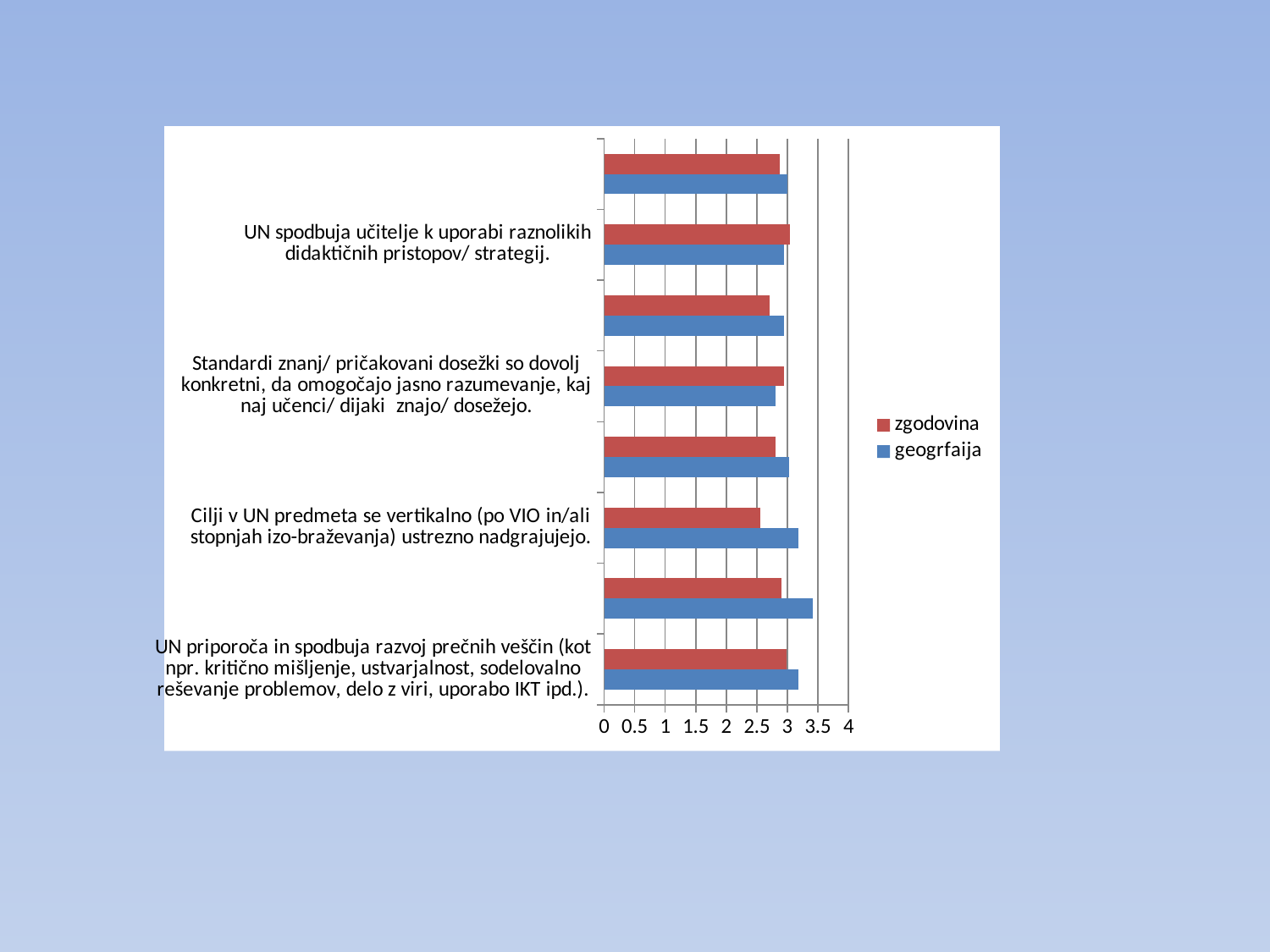
What kind of chart is shown on the slide? bar chart Is the zgodovina value for 'UN spodbuja učitelje k uporabi raznolikih didaktičnih pristopov/ strategij.' greater or less than 3.5? less Which colour represents the series zgodovina? red What are the two series named in the legend? zgodovina and geogrfaija How many series does the legend list? 2 Is the zgodovina value for 'UN priporoča in spodbuja razvoj prečnih veščin (kot npr. kritično mišljenje, ustvarjalnost, sodelovalno reševanje problemov, delo z viri, uporabo IKT ipd.).' greater or less than 2.5? greater What is the highest value shown on the horizontal axis? 4 Is the geogrfaija value for 'Standardi znanj/ pričakovani dosežki so dovolj konkretni, da omogočajo jasno razumevanje, kaj naj učenci/ dijaki znajo/ dosežejo.' greater or less than 2.5? greater Which category has the lowest value for zgodovina? Cilji v UN predmeta se vertikalno (po VIO in/ali stopnjah izo-braževanja) ustrezno nadgrajujejo. For 'Cilji v UN predmeta se vertikalno (po VIO in/ali stopnjah izo-braževanja) ustrezno nadgrajujejo.', which series has the larger value, zgodovina or geogrfaija? geogrfaija